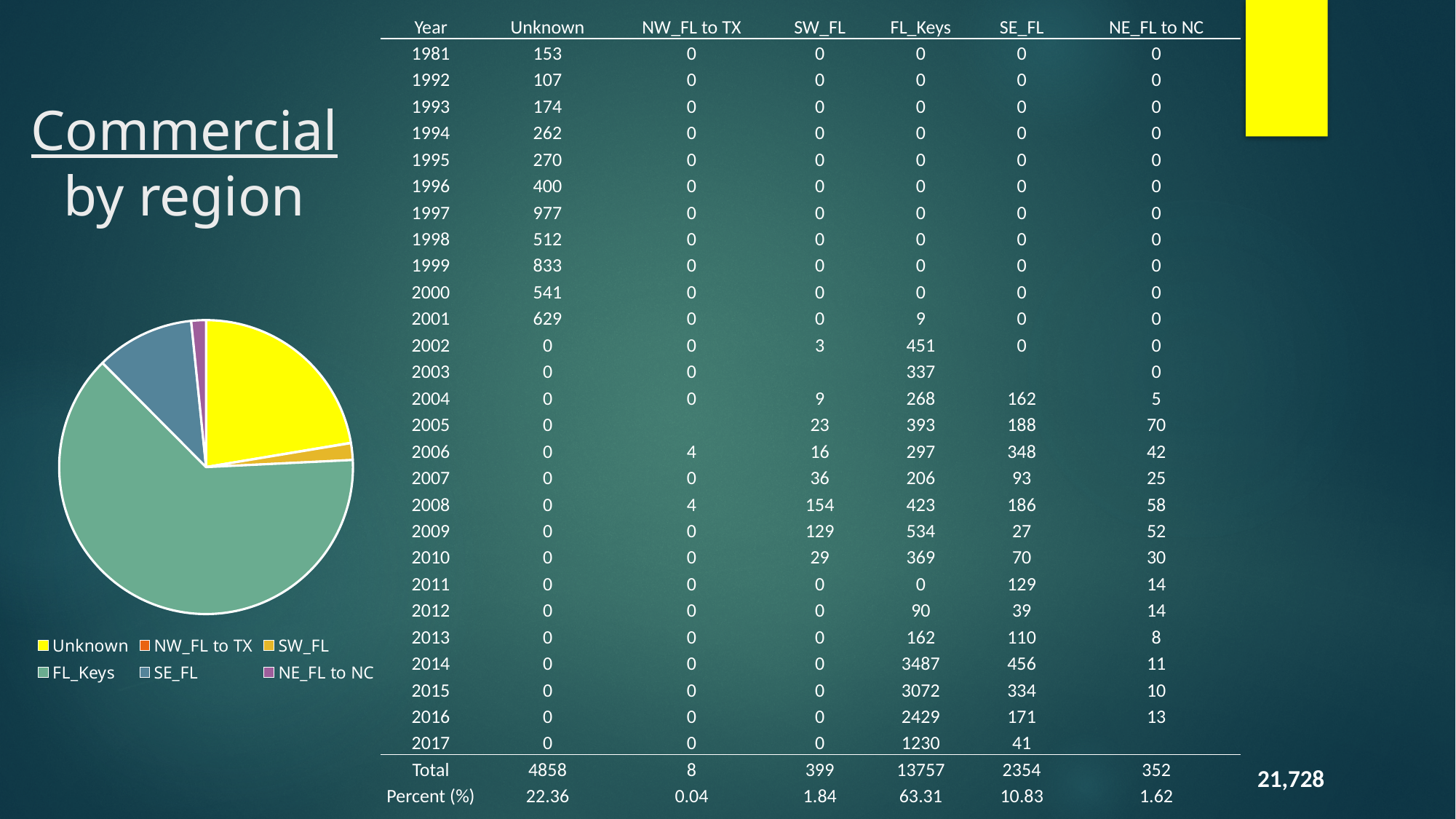
In the pie chart, which slice is larger: FL_Keys or Unknown? FL_Keys In the pie chart, which slice is larger: SE_FL or SW_FL? SE_FL In the pie chart, which slice is larger: Unknown or SE_FL? Unknown Is the share of the pie for FL_Keys greater or less than 50%? greater What colour is the FL_Keys slice in the pie chart? green How many categories does the pie chart's legend list? 6 Is the share of the pie for Unknown greater or less than 50%? less What kind of chart is shown on the left of the slide? pie chart What colour is the Unknown slice in the pie chart? yellow Is the share of the pie for SE_FL greater or less than 25%? less Which category has the largest slice in the pie chart? FL_Keys Which category has the second-largest slice in the pie chart? Unknown